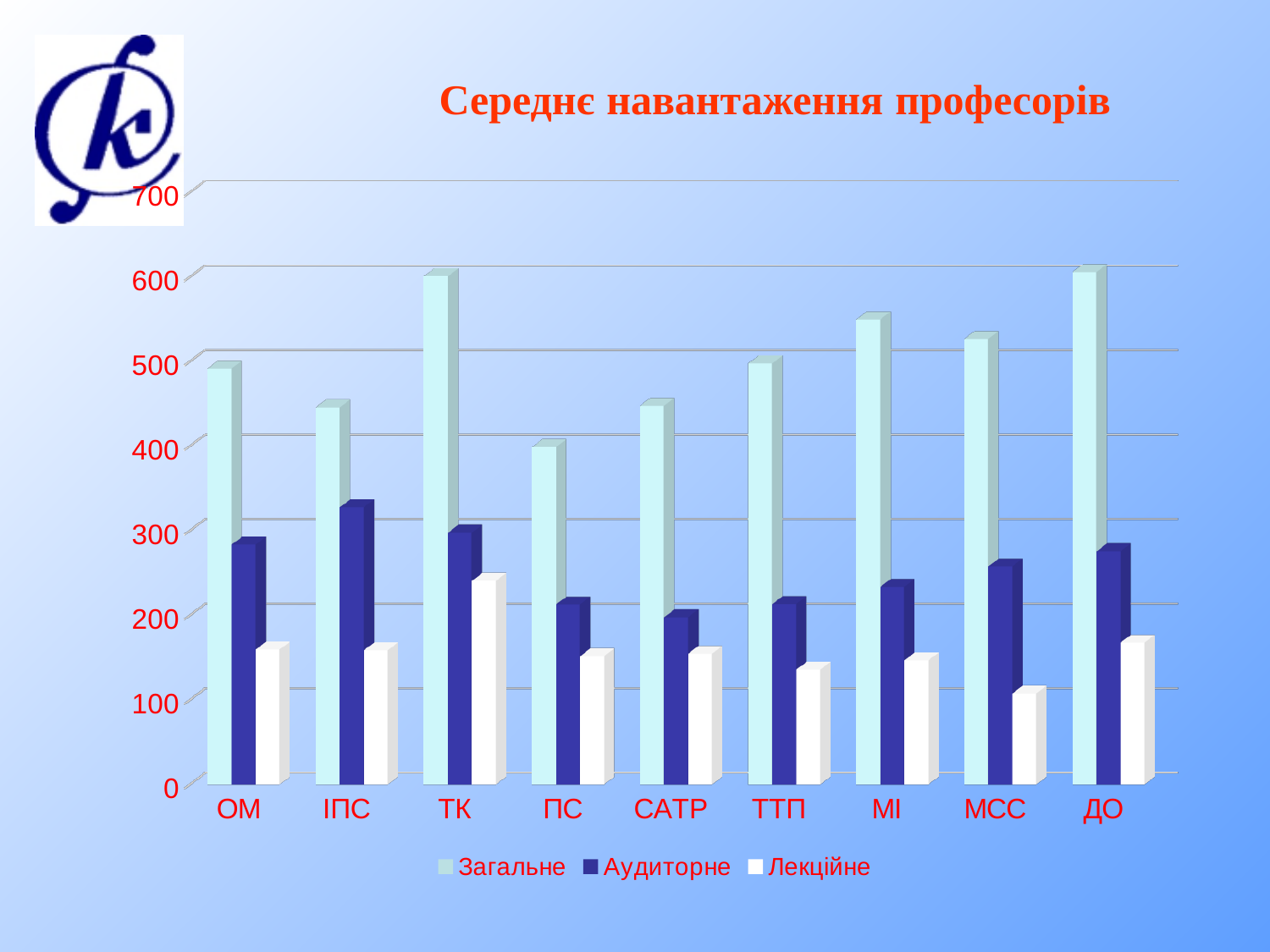
How many categories are shown on the x axis? 9 What is the title of the chart? Середнє навантаження професорів Which category has the highest value for the Аудиторне series? ІПС Which is larger, the Аудиторне value for ІПС or for САТР? ІПС Is the Лекційне value for МСС greater or less than 200? less Is the Аудиторне value for ПС greater or less than 300? less Which is larger, the Загальне value for ТК or for ПС? ТК What kind of chart is shown on the slide? bar chart Is the Загальне value for ТК greater or less than 500? greater Which category has the highest value for the Лекційне series? ТК Which category has the lowest value for the Лекційне series? МСС How many series does the legend list? 3